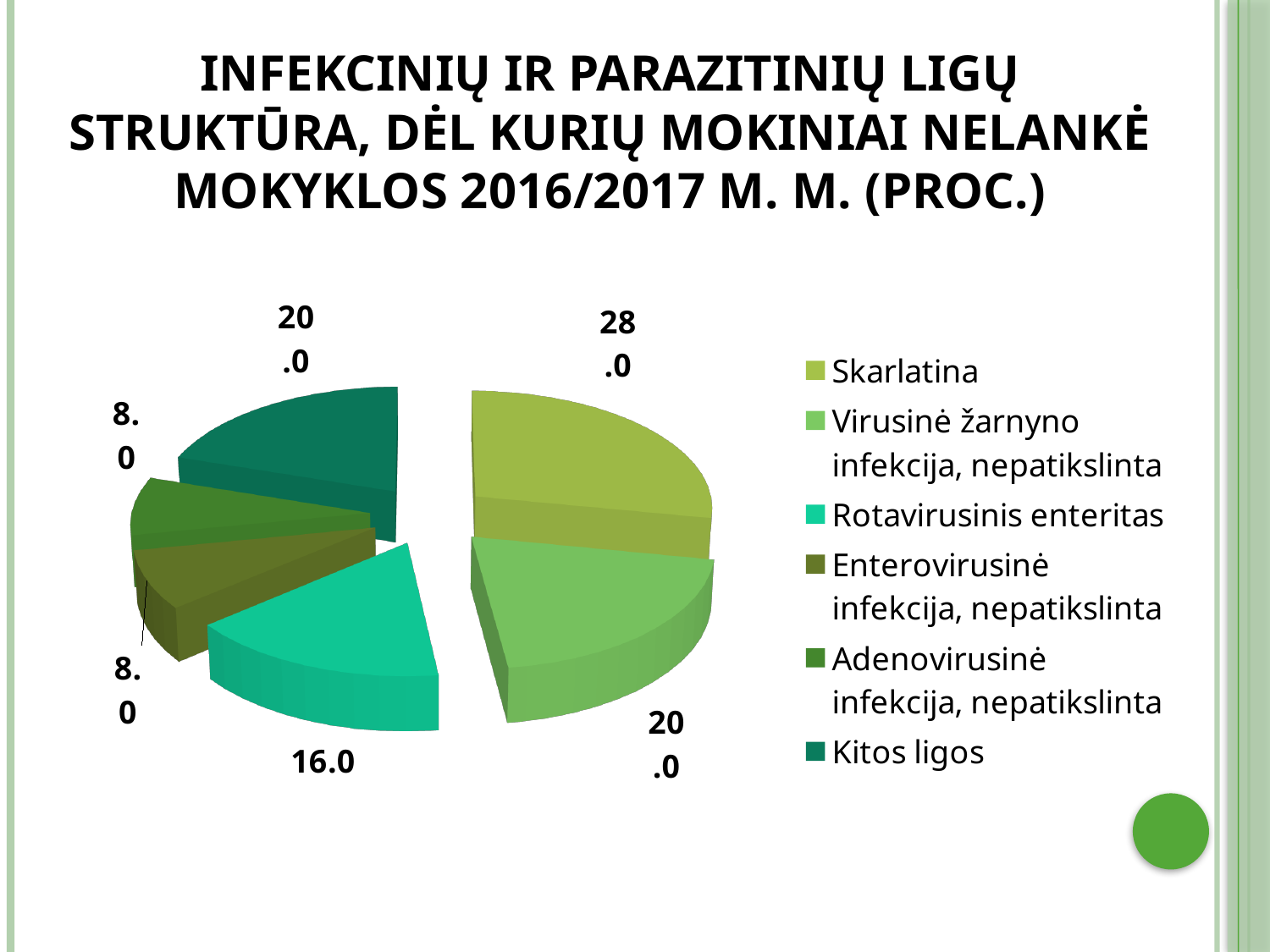
What is the value for Enterovirusinė infekcija, nepatikslinta? 8.0 Which is larger, the value for Virusinė žarnyno infekcija, nepatikslinta or the value for Rotavirusinis enteritas? Virusinė žarnyno infekcija, nepatikslinta Which legend entry is shown in the darkest teal colour? Kitos ligos How many entries does the legend list? 6 What is the value for Skarlatina? 28.0 What is the difference between the values for Skarlatina and Rotavirusinis enteritas? 12.0 What kind of chart is shown on the slide? pie chart What is the value for Rotavirusinis enteritas? 16.0 Which category has the largest slice? Skarlatina What is the difference between the values for Kitos ligos and Adenovirusinė infekcija, nepatikslinta? 12.0 How many slices does the pie chart have? 6 What is the value for Kitos ligos? 20.0